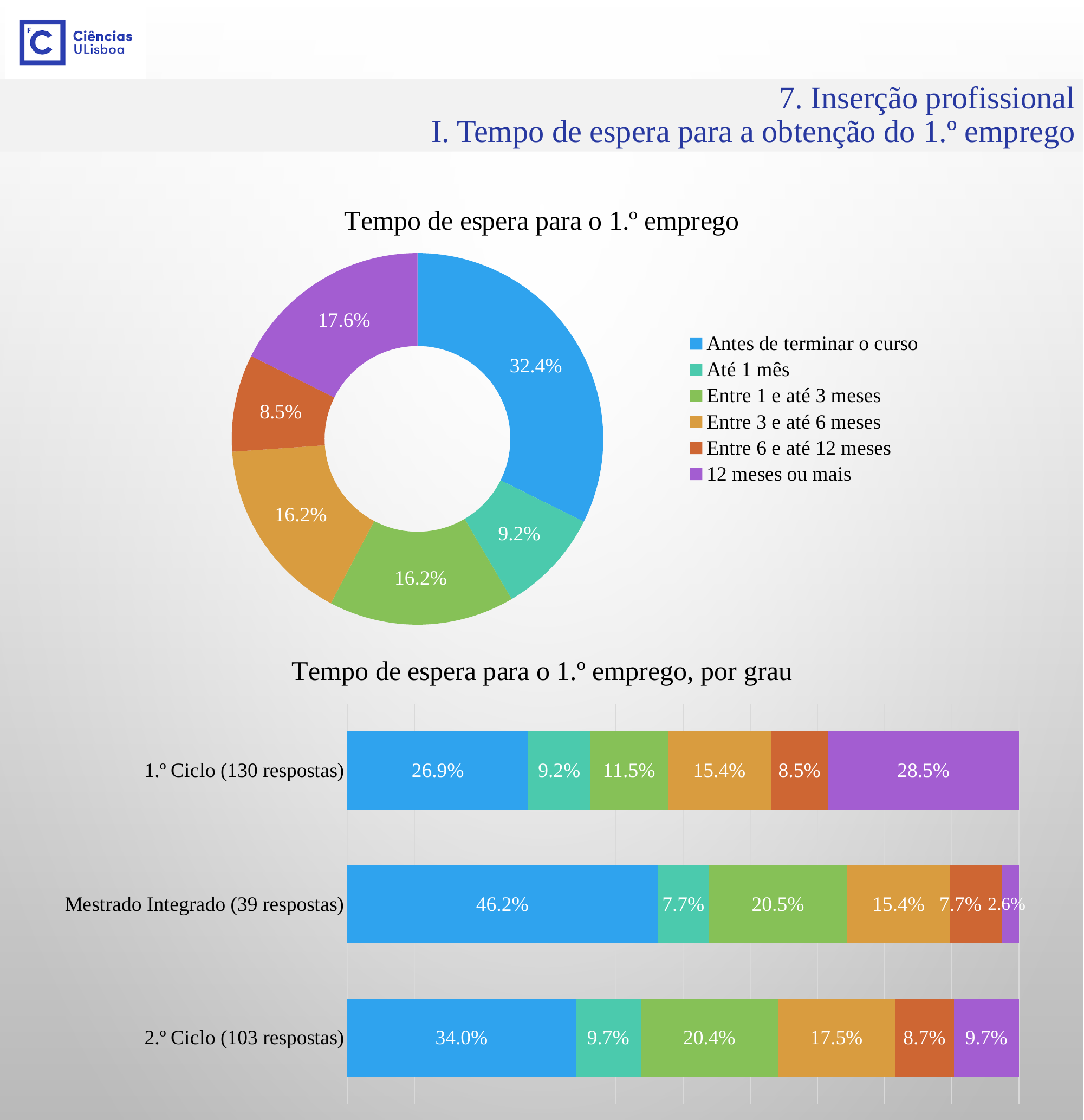
In the chart titled "Tempo de espera para o 1.º emprego", what share is shown for "12 meses ou mais"? 17.6% In the chart titled "Tempo de espera para o 1.º emprego", what is the difference between the shares for "Antes de terminar o curso" and "Até 1 mês"? 23.2% In the chart titled "Tempo de espera para o 1.º emprego, por grau", what is the value for "12 meses ou mais" in the "1.º Ciclo (130 respostas)" bar? 28.5% In the chart titled "Tempo de espera para o 1.º emprego", which category has the largest share? Antes de terminar o curso In the chart titled "Tempo de espera para o 1.º emprego", which category has the smallest share? Entre 6 e até 12 meses What kind of chart is "Tempo de espera para o 1.º emprego"? Doughnut chart What kind of chart is "Tempo de espera para o 1.º emprego, por grau"? Stacked bar chart In the chart titled "Tempo de espera para o 1.º emprego", what share is shown for "Antes de terminar o curso"? 32.4% In the chart titled "Tempo de espera para o 1.º emprego", how many categories does the legend list? 6 In the chart titled "Tempo de espera para o 1.º emprego, por grau", which degree has the largest value for "Antes de terminar o curso"? Mestrado Integrado (39 respostas) In the chart titled "Tempo de espera para o 1.º emprego, por grau", is the "12 meses ou mais" value larger for "1.º Ciclo (130 respostas)" or for "2.º Ciclo (103 respostas)"? 1.º Ciclo (130 respostas) In the chart titled "Tempo de espera para o 1.º emprego, por grau", what is the value for "Antes de terminar o curso" in the "Mestrado Integrado (39 respostas)" bar? 46.2%